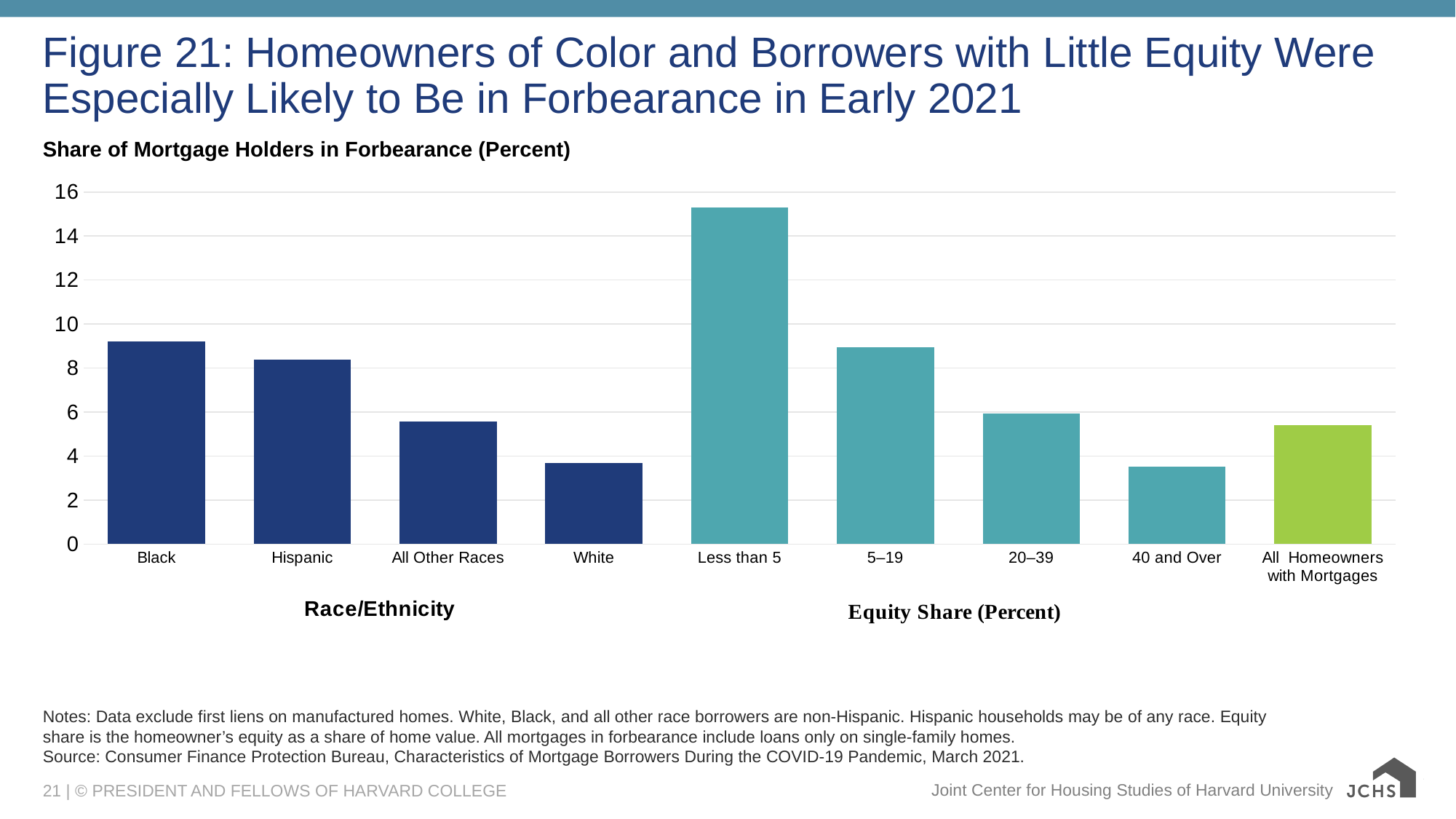
Is the value for Less than 5 greater or less than 14? greater What kind of chart is shown on the slide? Bar chart Among the Equity Share (Percent) categories, which has the lowest share in forbearance? 40 and Over Is the value for Black greater or less than 8? greater Among the Race/Ethnicity categories, which has the lowest share in forbearance? White How many bars (categories) are plotted in the chart? 9 What are the two group labels shown beneath the category axis? Race/Ethnicity and Equity Share (Percent) Is the value for 40 and Over greater or less than 4? less Which is larger, the value for White or the value for All Homeowners with Mortgages? All Homeowners with Mortgages Which is larger, the value for Black or the value for Hispanic? Black What is the axis title shown above the chart? Share of Mortgage Holders in Forbearance (Percent) Which category has the highest share of mortgage holders in forbearance? Less than 5